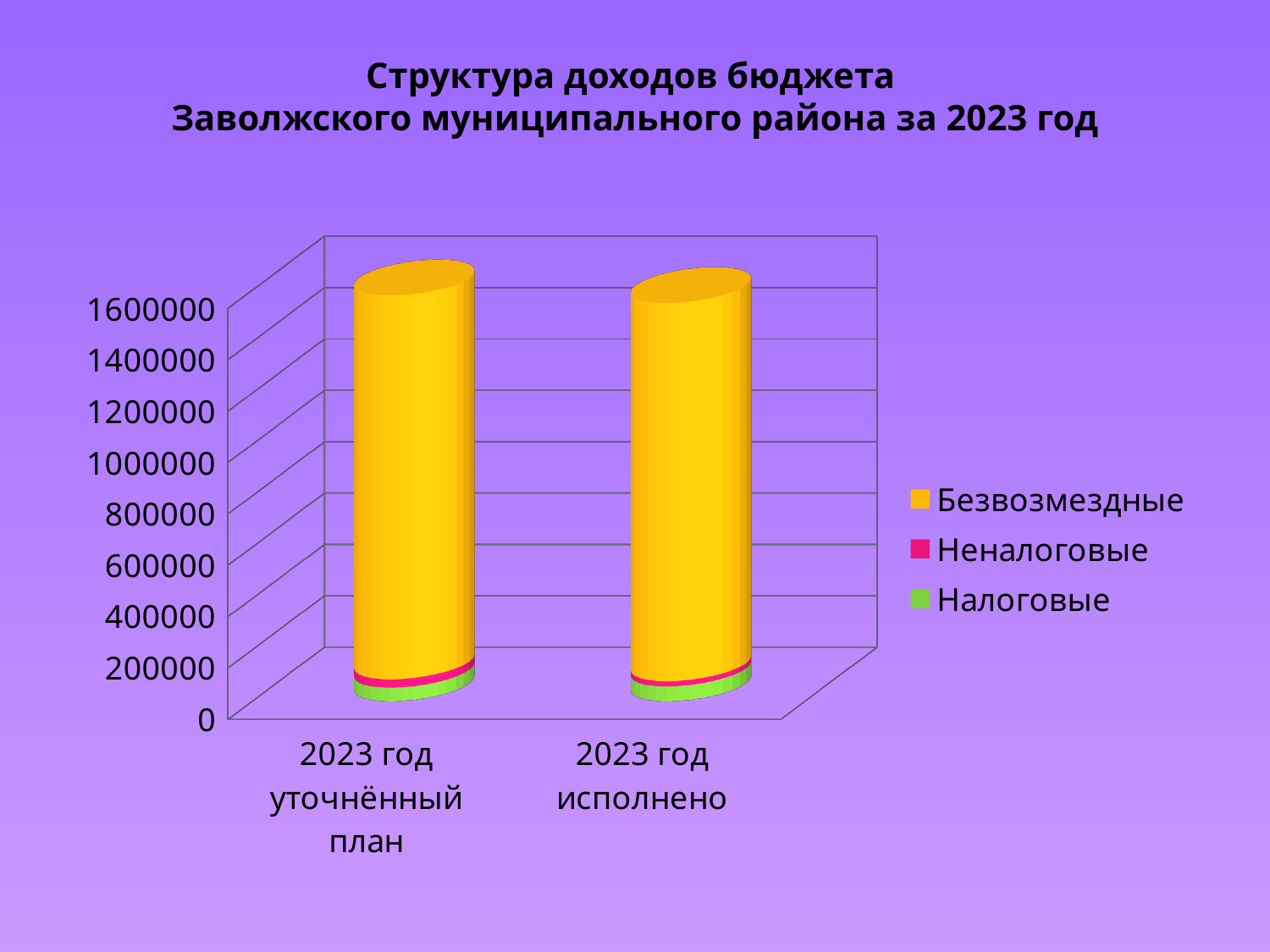
Is the value of the "Неналоговые" segment for "2023 год уточнённый план" greater or less than 400000? less Is the total value of the bar for "2023 год уточнённый план" greater or less than 1000000? greater What is the title of the chart? Структура доходов бюджета Заволжского муниципального района за 2023 год Is the total value of the bar for "2023 год исполнено" greater or less than 1000000? greater How many series does the legend list? 3 Which series is shown in yellow in the chart? Безвозмездные What is the highest value labelled on the vertical axis of the chart? 1600000 Which series makes up the largest part of the bar for "2023 год исполнено"? Безвозмездные What kind of chart is shown on the slide? Stacked bar chart How many categories are shown on the x axis of the chart? 2 Which series makes up the largest part of the bar for "2023 год уточнённый план"? Безвозмездные